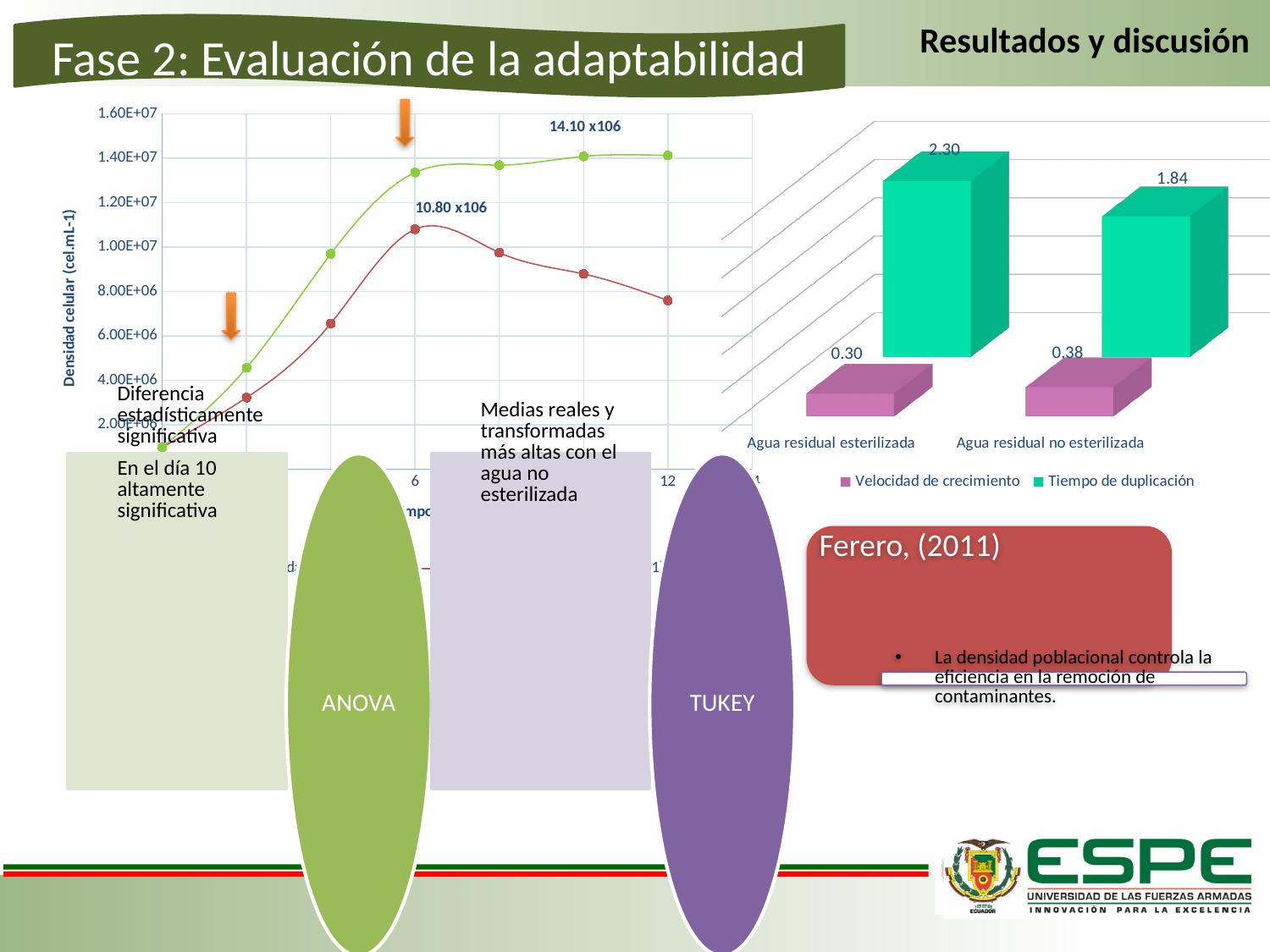
On the bar chart on the right, what is the Tiempo de duplicación value for Agua residual esterilizada? 2.30 What kind of chart is the chart on the right of the slide? Bar chart On the bar chart on the right, what is the Velocidad de crecimiento value for Agua residual no esterilizada? 0.38 On the bar chart on the right, what is the Velocidad de crecimiento value for Agua residual esterilizada? 0.30 What kind of chart is the chart on the left of the slide? Line chart On the bar chart on the right, how many series does the legend list? 2 On the bar chart on the right, which category has the higher Velocidad de crecimiento? Agua residual no esterilizada On the bar chart on the right, how many categories are shown on the x axis? 2 On the line chart on the left, what is the highest data label shown? 14.10 x106 On the bar chart on the right, what is the difference between the Tiempo de duplicación values for Agua residual esterilizada and Agua residual no esterilizada? 0.46 On the line chart on the left, what is the label of the y axis? Densidad celular (cel.mL-1) On the bar chart on the right, what is the Tiempo de duplicación value for Agua residual no esterilizada? 1.84